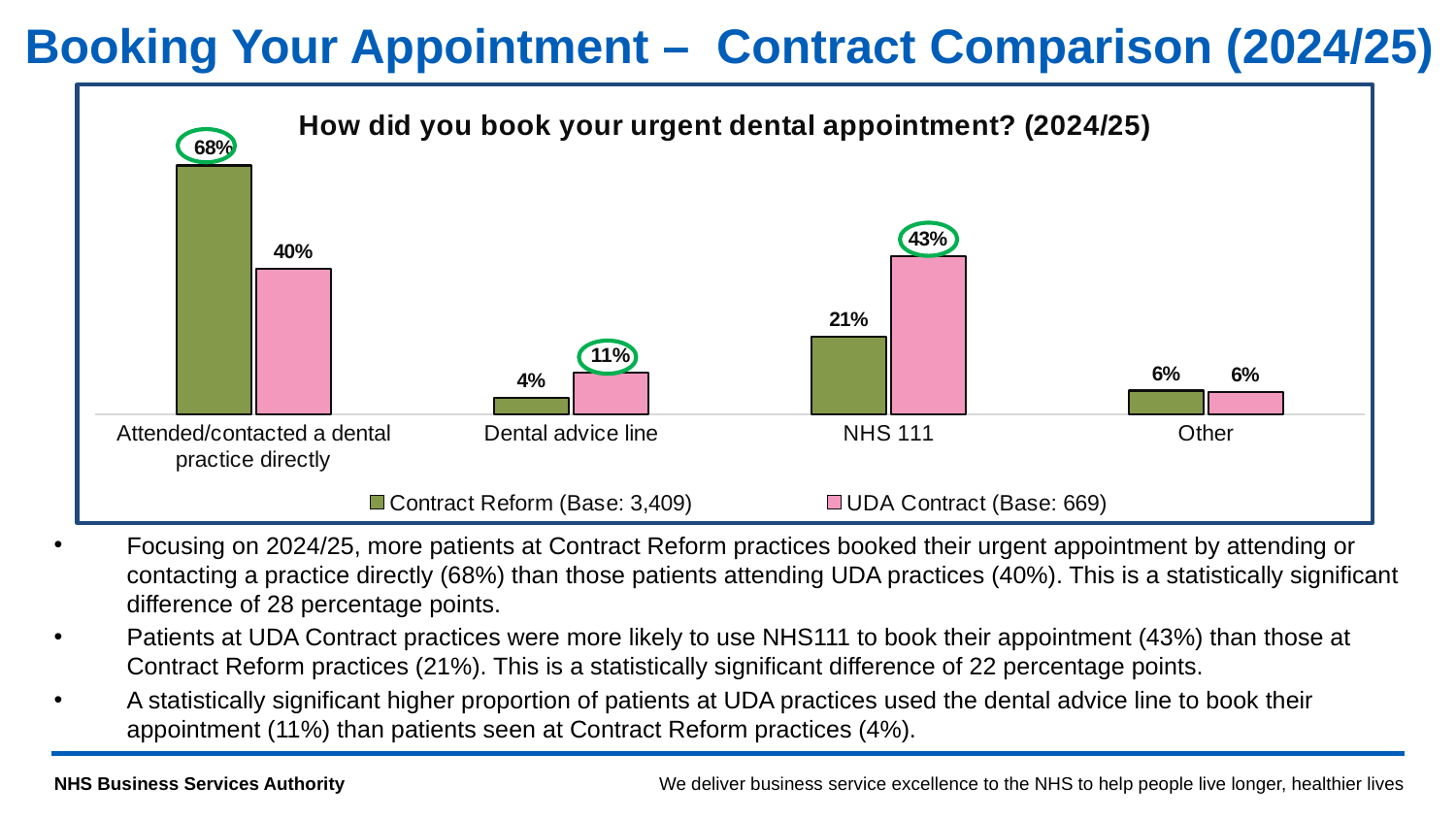
Which booking method has the lowest value for the Contract Reform series? Dental advice line What is the title of the chart? How did you book your urgent dental appointment? (2024/25) How many series does the legend list? 2 Which series has the larger value for Dental advice line, Contract Reform or UDA Contract? UDA Contract What is the value for Dental advice line in the Contract Reform series? 4% What kind of chart is shown on the slide? Bar chart Which booking method has the highest value for the UDA Contract series? NHS 111 What is the difference between the Contract Reform and UDA Contract values for Attended/contacted a dental practice directly? 28 percentage points What percentage of UDA Contract patients booked via NHS 111? 43% What percentage of Contract Reform patients attended/contacted a dental practice directly? 68% How many booking method categories are shown on the x axis? 4 What is the base size for the UDA Contract series shown in the legend? 669